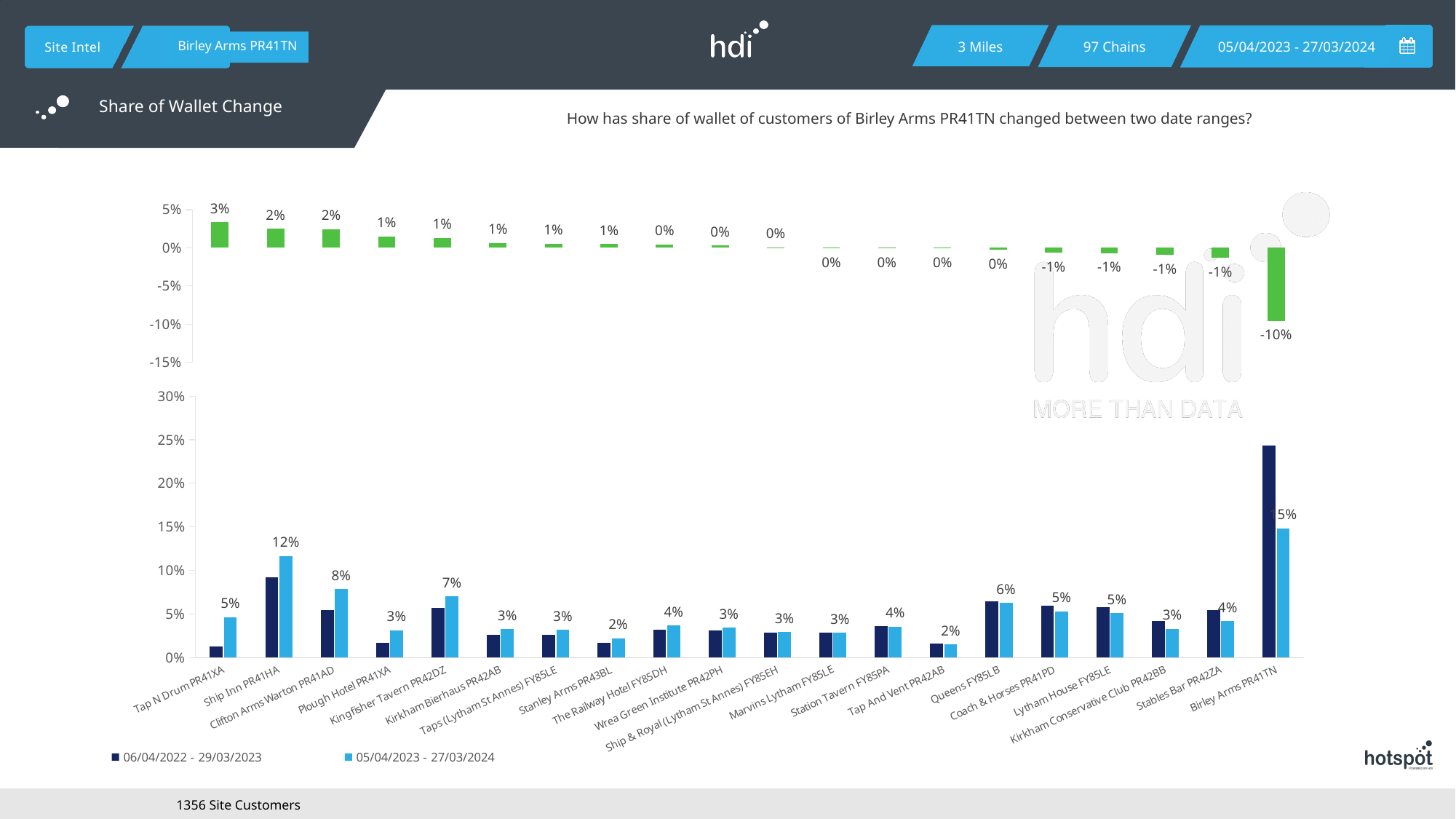
In the bottom chart, which has the larger 05/04/2023 - 27/03/2024 value: Clifton Arms Warton PR41AD or Kingfisher Tavern PR42DZ? Clifton Arms Warton PR41AD In the bottom chart, what is the difference between the 05/04/2023 - 27/03/2024 values for Birley Arms PR41TN and Ship Inn PR41HA? 3% In the top chart, which category has the highest share of wallet change? Tap N Drum PR41XA What kind of chart is the bottom chart? bar chart In the bottom chart, what is the value for Ship Inn PR41HA in the 05/04/2023 - 27/03/2024 series? 12% In the bottom chart, is the 06/04/2022 - 29/03/2023 value for Birley Arms PR41TN greater or less than 20%? greater In the top chart, what is the share of wallet change for Birley Arms PR41TN? -10% In the top chart, what is the share of wallet change for Coach & Horses PR41PD? -1% How many series does the legend of the bottom chart list? 2 What are the two date ranges listed in the legend of the bottom chart? 06/04/2022 - 29/03/2023 and 05/04/2023 - 27/03/2024 How many categories are shown on the x axis of the bottom chart? 20 In the top chart, which category has the lowest share of wallet change? Birley Arms PR41TN